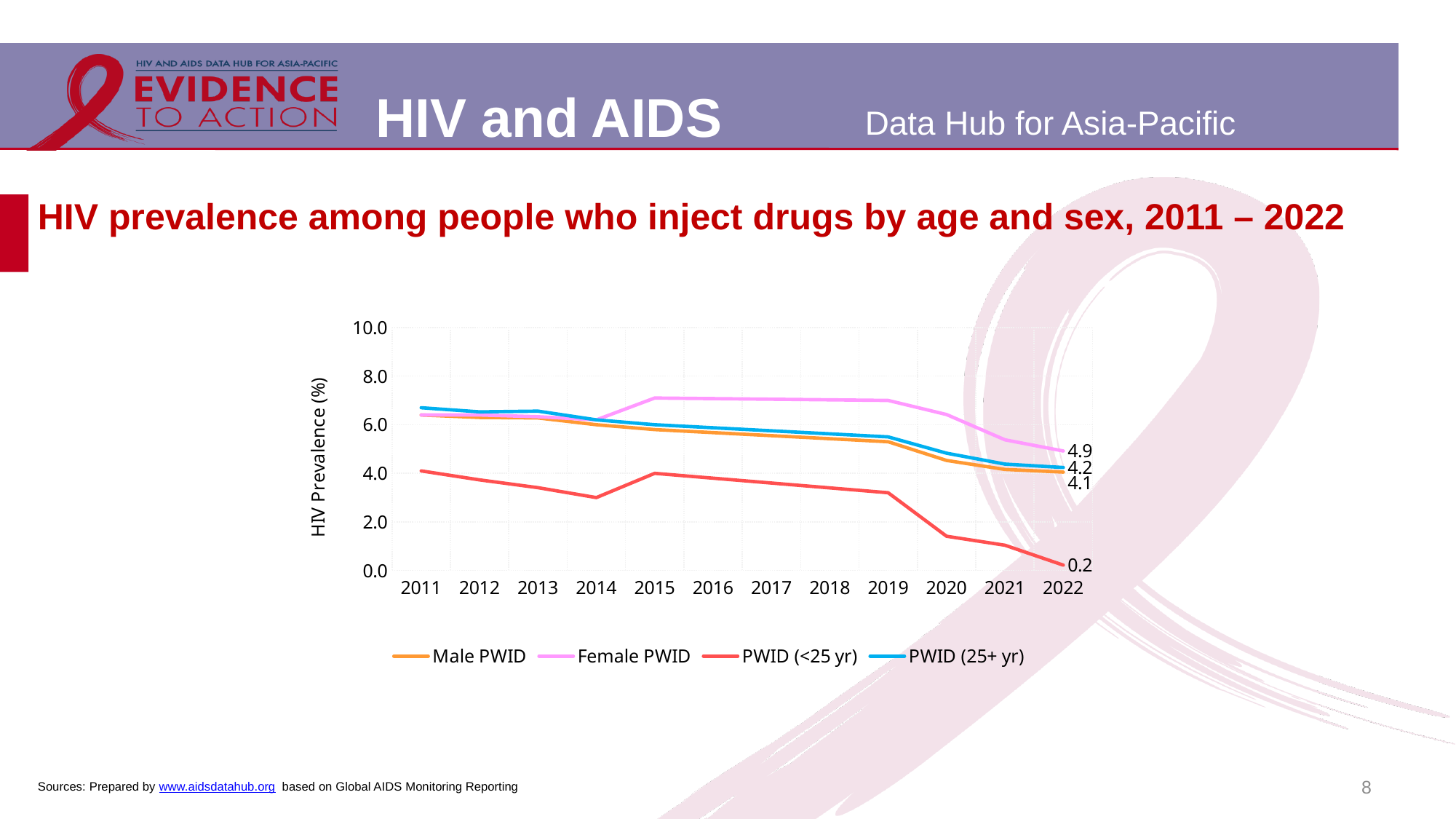
How many years are shown on the x axis? 12 In 2022, which is larger: the value for Female PWID or the value for PWID (<25 yr)? Female PWID What is the HIV prevalence for Female PWID in 2022? 4.9 Is the value for Female PWID in 2015 greater or less than 6.0? greater What kind of chart is shown on the slide? Line chart What is the difference between the 2022 values for Female PWID and PWID (<25 yr)? 4.7 What is the HIV prevalence for PWID (<25 yr) in 2022? 0.2 Which series has the highest HIV prevalence in 2022? Female PWID What is the HIV prevalence for PWID (25+ yr) in 2022? 4.2 Which series has the lowest HIV prevalence in 2022? PWID (<25 yr) What is the HIV prevalence for Male PWID in 2022? 4.1 How many series does the legend list? 4